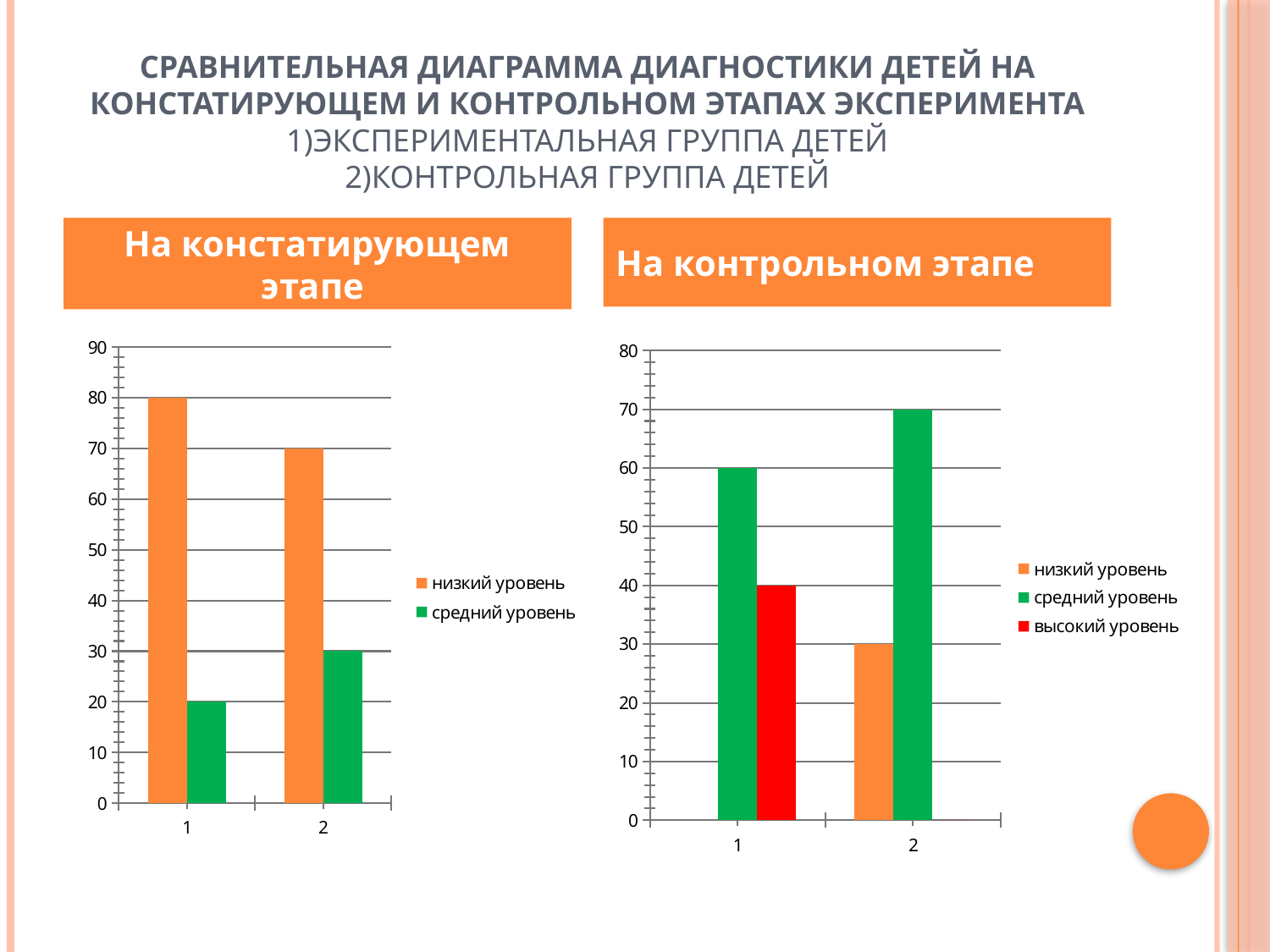
In the chart titled "На констатирующем этапе", does the value of низкий уровень rise or fall from category 1 to category 2? fall In the chart titled "На констатирующем этапе", what is the value of средний уровень for category 2? 30 In the chart titled "На контрольном этапе", which series has the highest value for category 2? средний уровень In the chart titled "На констатирующем этапе", which series has the higher value for category 2, низкий уровень or средний уровень? низкий уровень What kind of chart is the chart titled "На контрольном этапе"? bar chart In the chart titled "На контрольном этапе", how many series does the legend list? 3 In the chart titled "На констатирующем этапе", how many series does the legend list? 2 In the chart titled "На контрольном этапе", what is the value of средний уровень for category 1? 60 In the chart titled "На контрольном этапе", what is the value of низкий уровень for category 2? 30 In the chart titled "На констатирующем этапе", what is the difference between низкий уровень and средний уровень for category 1? 60 In the chart titled "На контрольном этапе", what is the value of высокий уровень for category 1? 40 In the chart titled "На констатирующем этапе", what is the value of низкий уровень for category 1? 80